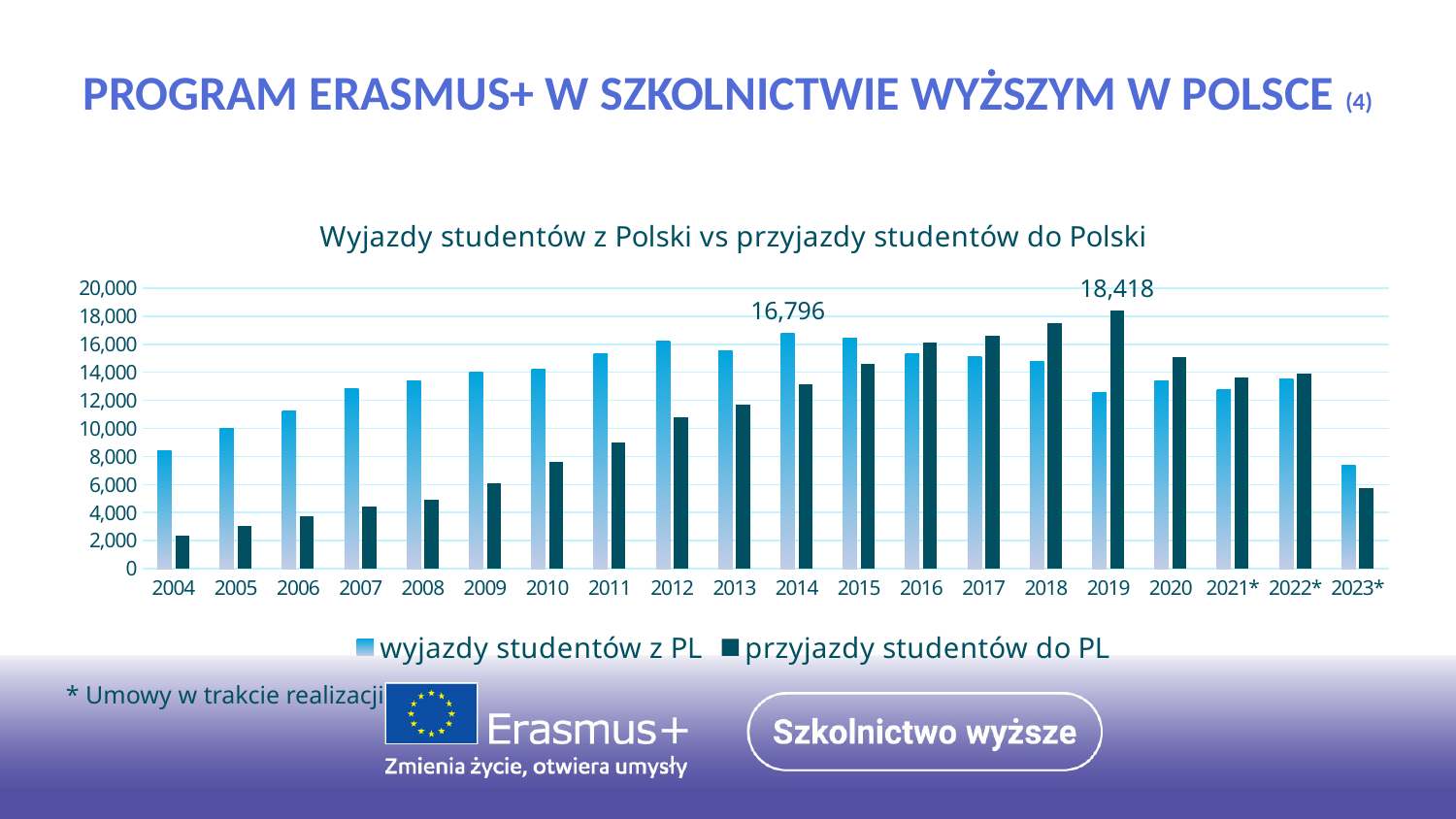
What kind of chart is shown on the slide? bar chart Is the value for wyjazdy studentów z PL in 2012 greater or less than 14,000? greater How many years are shown on the x axis of the chart? 20 In which year is the value for przyjazdy studentów do PL the highest? 2019 In which year is the value for wyjazdy studentów z PL the highest? 2014 What is the value for przyjazdy studentów do PL in 2019? 18,418 What is the value for wyjazdy studentów z PL in 2014? 16,796 In which year is the value for przyjazdy studentów do PL the lowest? 2004 How many series does the legend list? 2 What is the difference between the labelled value for przyjazdy studentów do PL in 2019 and the labelled value for wyjazdy studentów z PL in 2014? 1,622 Is the value for przyjazdy studentów do PL in 2004 greater or less than 4,000? less In 2004, which series has the larger value: wyjazdy studentów z PL or przyjazdy studentów do PL? wyjazdy studentów z PL